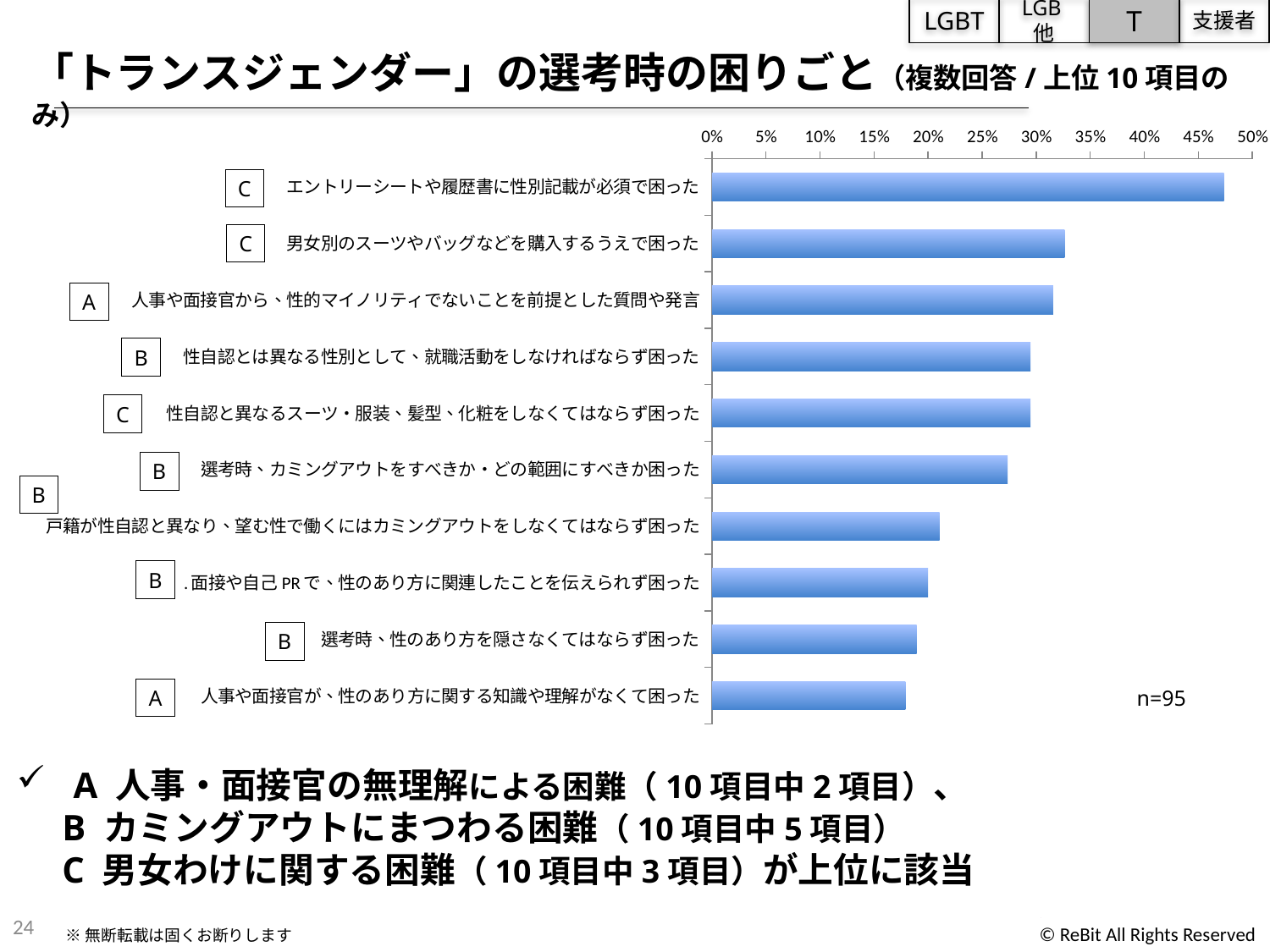
Which is larger: the value for エントリーシートや履歴書に性別記載が必須で困った or the value for 人事や面接官が、性のあり方に関する知識や理解がなくて困った? エントリーシートや履歴書に性別記載が必須で困った Which item has the highest value in the chart? エントリーシートや履歴書に性別記載が必須で困った What is the sample size (n) shown on the chart? n=95 How many categories (items) are plotted in the chart? 10 Is the value for 戸籍が性自認と異なり、望む性で働くにはカミングアウトをしなくてはならず困った greater or less than 25%? less Is the value for 人事や面接官が、性のあり方に関する知識や理解がなくて困った greater or less than 20%? less Which is larger: the value for 男女別のスーツやバッグなどを購入するうえで困った or the value for 選考時、カミングアウトをすべきか・どの範囲にすべきか困った? 男女別のスーツやバッグなどを購入するうえで困った What kind of chart is shown on the slide? bar chart What is the maximum value shown on the chart's percentage axis? 50% Is the value for エントリーシートや履歴書に性別記載が必須で困った greater or less than 40%? greater